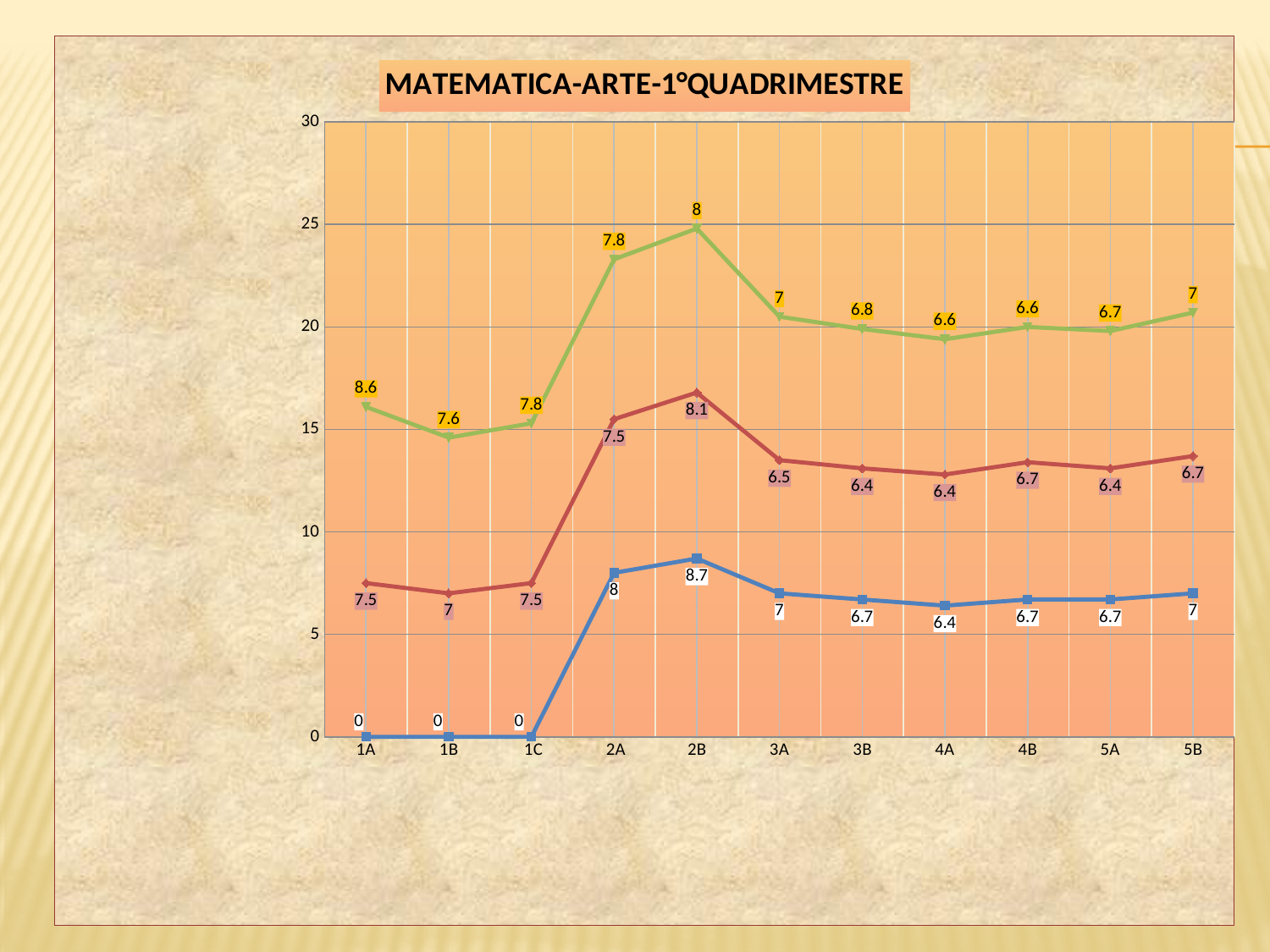
At 2A, which is larger: the blue line's value or the red line's value? the blue line (8) At which category does the green line reach its highest value? 1A What is the value of the red line at 3A? 6.5 What is the title of the chart? MATEMATICA-ARTE-1°QUADRIMESTRE How many categories are shown on the x axis? 11 What is the value of the blue line at 1C? 0 What kind of chart is shown on the slide? line chart What is the value of the green line at 1A? 8.6 At which category does the blue line reach its highest value? 2B What is the value of the blue line at 2B? 8.7 What is the difference between the green line's value at 2B and its value at 1B? 0.4 Does the blue line rise or fall from 1C to 2B? rise